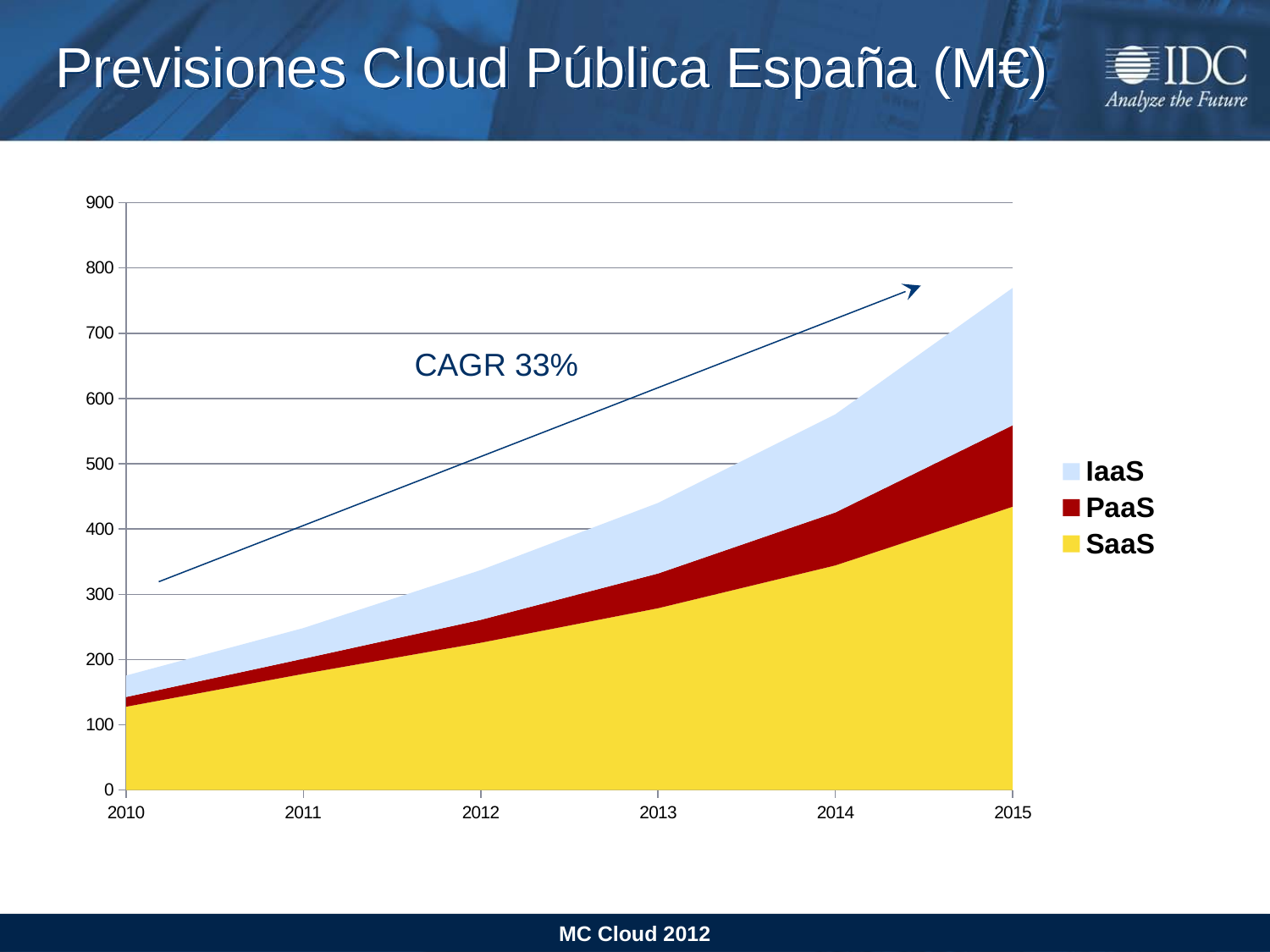
Which year has the highest total value? 2015 What CAGR is annotated on the chart? 33% Is the total value for 2015 greater or less than 700? greater What kind of chart is shown on the slide? Stacked area chart Is the total value for 2010 greater or less than 200? less In 2015, which is larger, the SaaS segment or the IaaS segment? SaaS Which year has the lowest total value? 2010 Is the SaaS value for 2015 greater or less than 400? greater Do the total values rise or fall from 2010 to 2015? Rise How many years are shown along the x axis? 6 Which series is shown in yellow? SaaS How many series does the legend list? 3